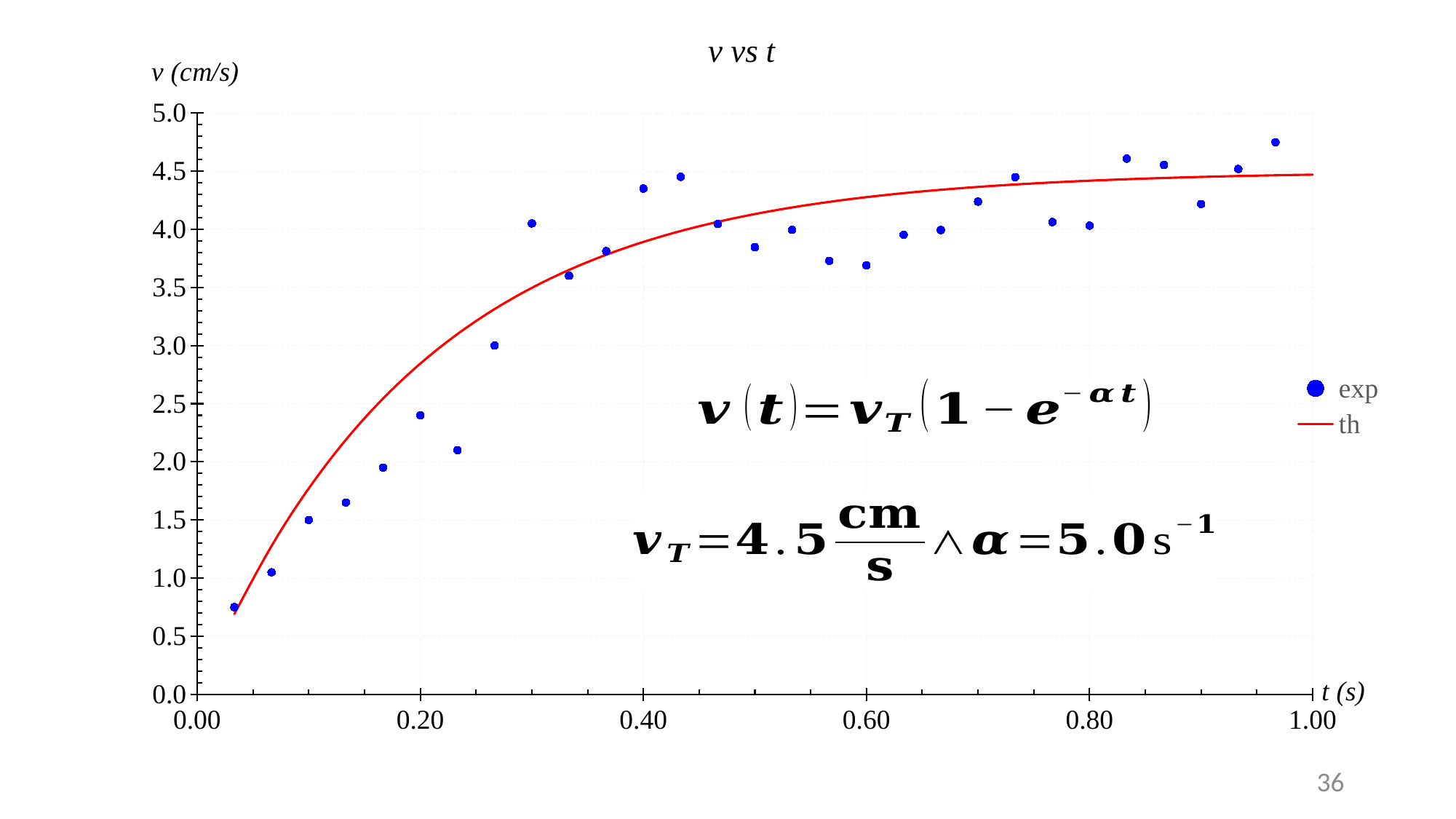
How many series does the legend list? 2 Which is larger, the exp value at t = 0.27 or at t = 0.30? t = 0.30 At which t value does the exp series reach its lowest point? The first point, near t = 0.03 Is the th curve value at t = 1.00 greater or less than 4.0? greater What are the two entries in the chart legend? exp and th Do the exp values generally rise or fall as t increases from 0.00 to 1.00? Rise Is the exp value at t = 0.20 greater or less than 2.0? greater What kind of chart is shown on the slide? Scatter chart with a fitted line What is the title of the chart? v vs t At which t value does the exp series reach its highest point? The last point, near t = 0.97 Is the exp value at the last point (t ≈ 0.97) greater or less than 4.5? greater